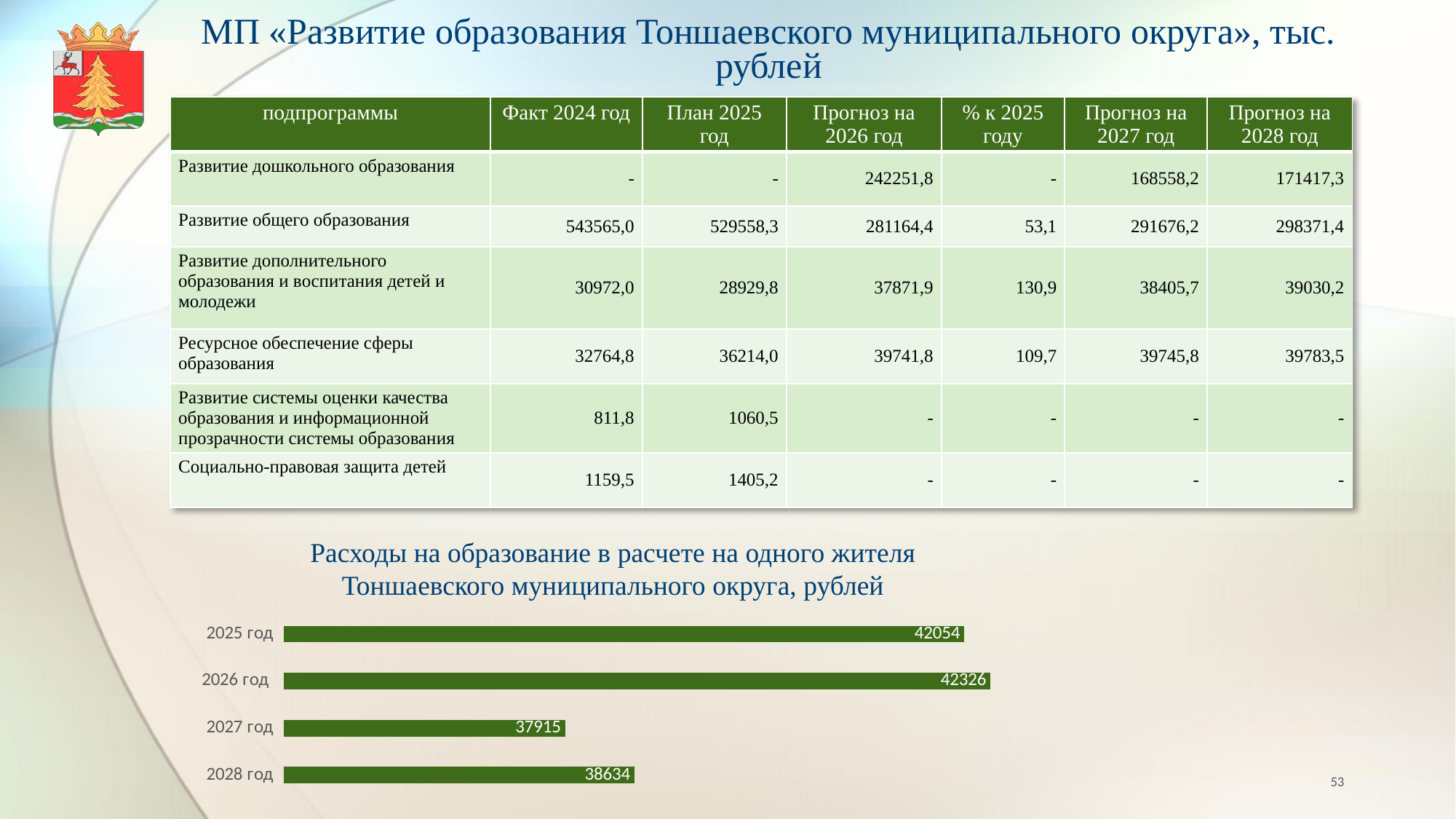
How many years are shown in the chart? 4 What is the value for 2027 год in the chart? 37915 What is the title of the chart on the slide? Расходы на образование в расчете на одного жителя Тоншаевского муниципального округа, рублей What is the difference between the values for 2028 год and 2027 год in the chart? 719 Which is larger in the chart: the value for 2025 год or the value for 2028 год? 2025 год What is the difference between the values for 2026 год and 2025 год in the chart? 272 Which year has the lowest value in the chart? 2027 год What is the value for 2028 год in the chart? 38634 What kind of chart is shown on the slide? bar chart What is the value for 2025 год in the chart? 42054 Which year has the highest value in the chart? 2026 год What is the value for 2026 год in the chart? 42326